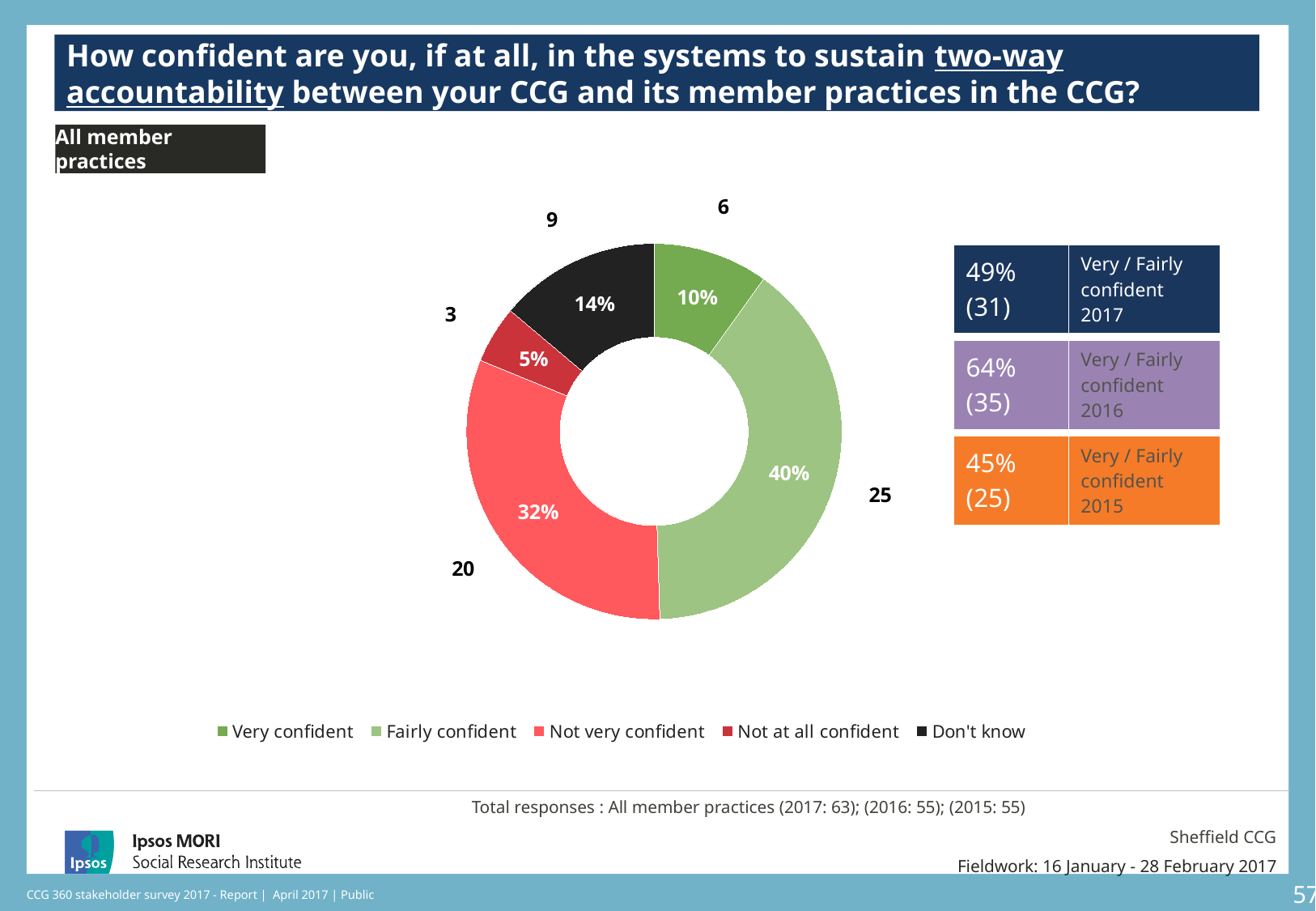
What was the combined Very / Fairly confident percentage in 2016? 64% What percentage of respondents are Not very confident? 32% What is the difference in percentage points between Fairly confident and Not very confident? 8 What percentage of respondents are Not at all confident? 5% How many respondents answered Don't know? 9 How many respondents were Very / Fairly confident in 2015? 25 How many response categories does the legend list? 5 What type of chart is shown on the slide? Donut (pie) chart Which response category has the largest share of the donut chart? Fairly confident Which response category has the smallest share of the donut chart? Not at all confident Which is larger, the share for Very confident or the share for Don't know? Don't know What percentage of respondents are Fairly confident? 40%